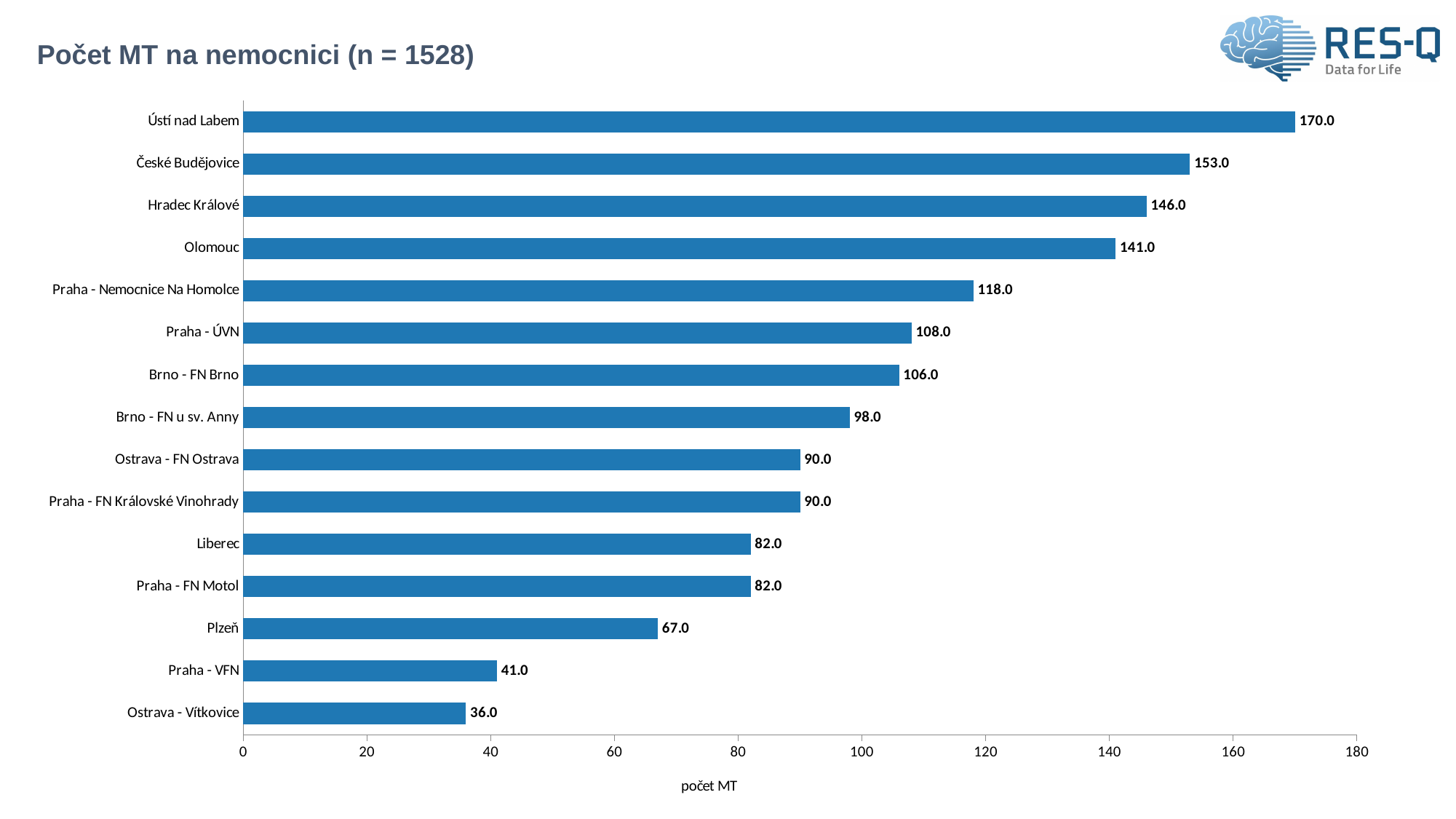
What is the difference between the values for Ústí nad Labem and České Budějovice? 17.0 What is the title of the chart? Počet MT na nemocnici (n = 1528) What is the value for Brno - FN u sv. Anny? 98.0 Which is larger, the value for Hradec Králové or the value for Praha - Nemocnice Na Homolce? Hradec Králové What is the value for Olomouc? 141.0 What is the difference between the values for Plzeň and Praha - VFN? 26.0 Is the value for Praha - ÚVN greater or less than 100? greater What kind of chart is shown on the slide? bar chart How many hospitals are shown in the chart? 15 Which hospital has the lowest number of MT? Ostrava - Vítkovice What is the value for Praha - FN Motol? 82.0 Which hospital has the highest number of MT? Ústí nad Labem